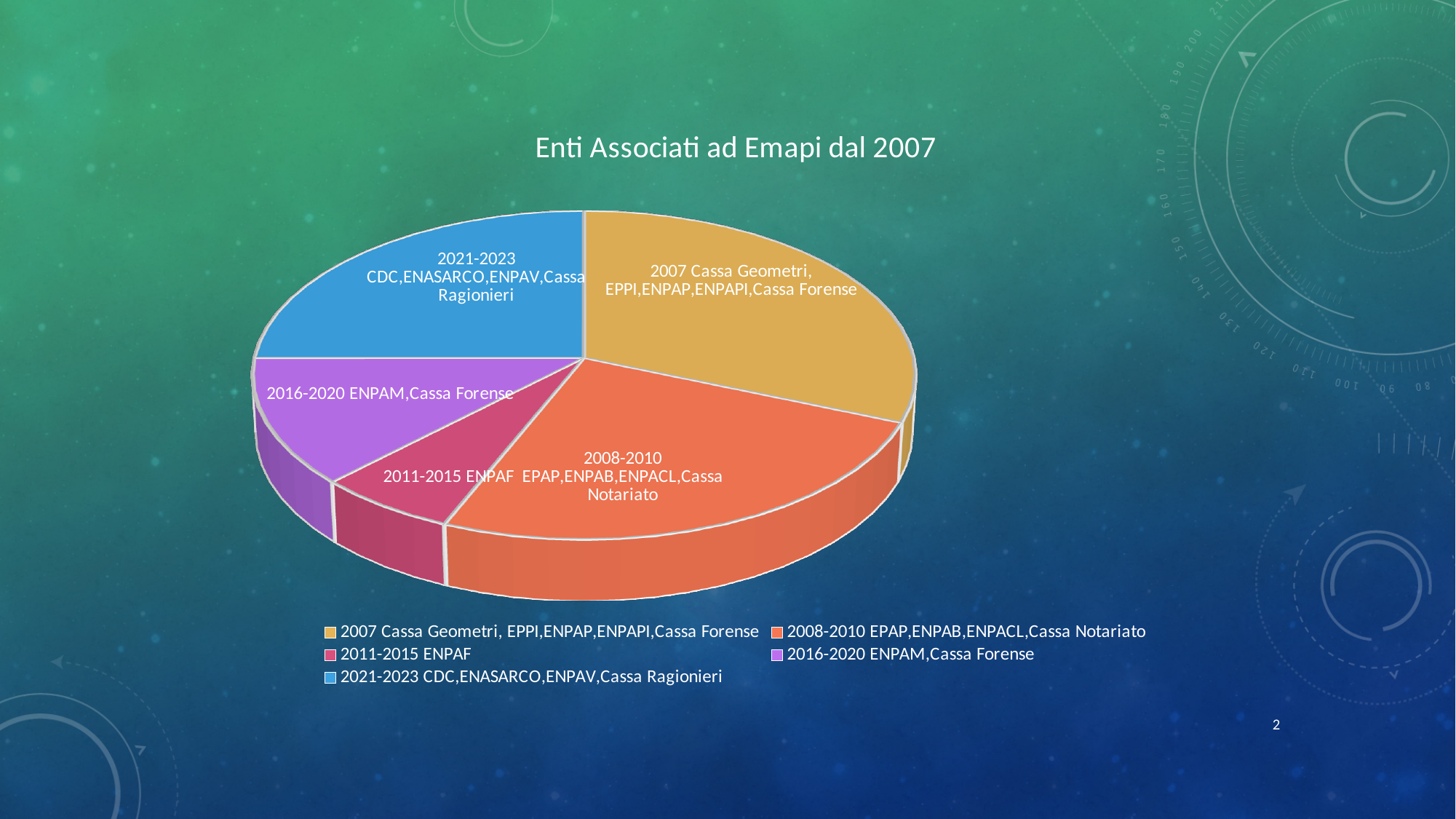
Which slice is larger: 2021-2023 CDC,ENASARCO,ENPAV,Cassa Ragionieri or 2011-2015 ENPAF? 2021-2023 CDC,ENASARCO,ENPAV,Cassa Ragionieri What colour is the slice for 2011-2015 ENPAF? pink/magenta What kind of chart is shown on the slide? pie chart Which slice is larger: 2016-2020 ENPAM,Cassa Forense or 2011-2015 ENPAF? 2016-2020 ENPAM,Cassa Forense How many entries does the legend list? 5 Which slice of the pie chart is the smallest? 2011-2015 ENPAF How many slices does the pie chart have? 5 Which slice is larger: 2008-2010 EPAP,ENPAB,ENPACL,Cassa Notariato or 2016-2020 ENPAM,Cassa Forense? 2008-2010 EPAP,ENPAB,ENPACL,Cassa Notariato What is the title of the chart? Enti Associati ad Emapi dal 2007